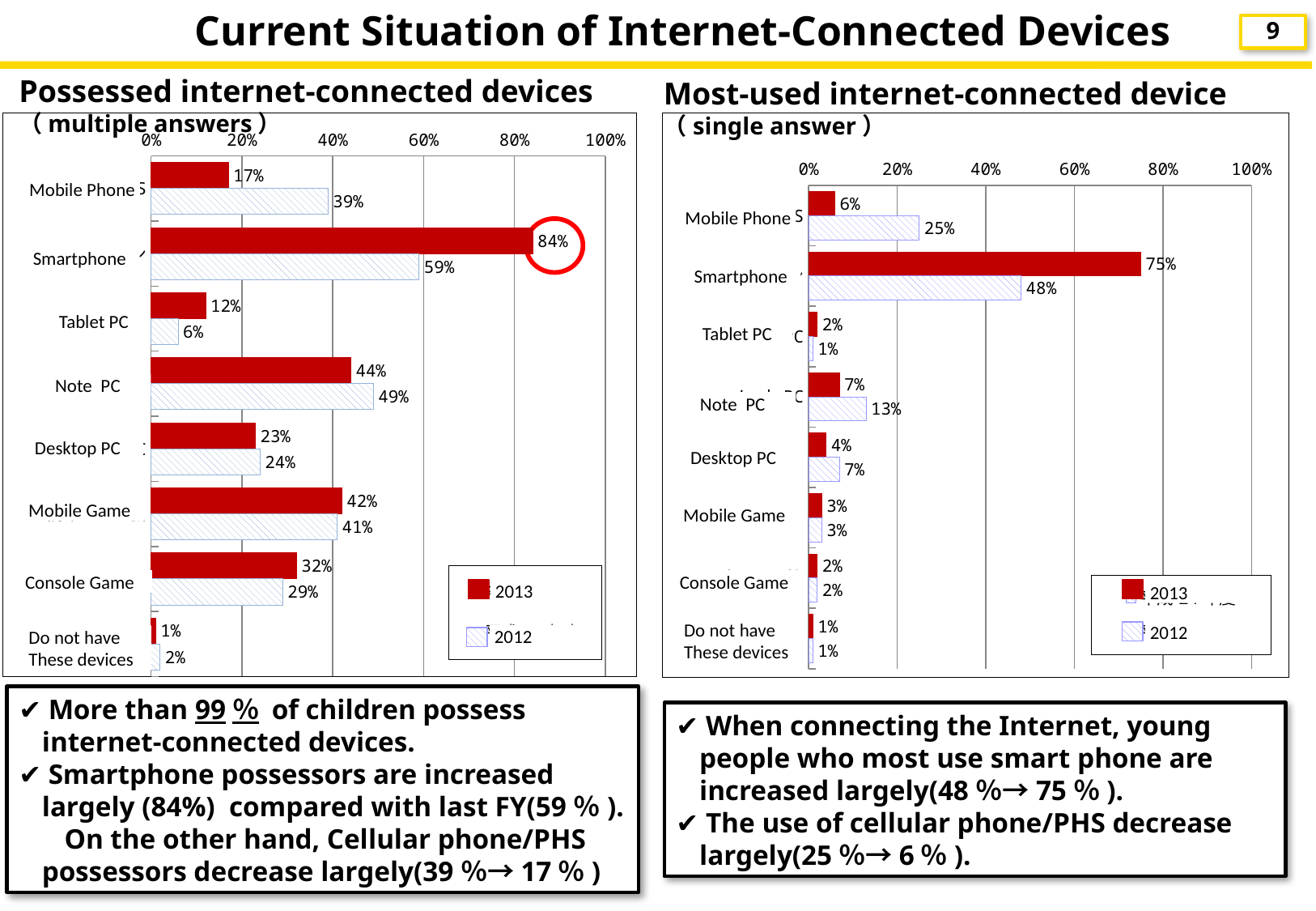
In the 'Possessed internet-connected devices' chart, how many categories are shown? 8 In the 'Most-used internet-connected device' chart, what is the difference between the 2012 and 2013 values for Mobile Phone? 19% In the 'Most-used internet-connected device' chart, what is the 2013 value for Smartphone? 75% In the 'Possessed internet-connected devices' chart, which category has the highest 2013 value? Smartphone In the 'Possessed internet-connected devices' chart, what is the 2013 value for Smartphone? 84% In the 'Possessed internet-connected devices' chart, what is the difference between the 2013 and 2012 values for Note PC? 5% In the 'Most-used internet-connected device' chart, what is the 2012 value for Note PC? 13% In the 'Possessed internet-connected devices' chart, what is the 2012 value for Mobile Phone? 39% How many series does the legend list in the 'Most-used internet-connected device' chart? 2 In the 'Most-used internet-connected device' chart, which category has the lowest 2012 value? Tablet PC and Do not have These devices (both 1%) In the 'Possessed internet-connected devices' chart, which is larger for Tablet PC: the 2013 value or the 2012 value? 2013 What type of chart is the 'Possessed internet-connected devices' chart? Bar chart